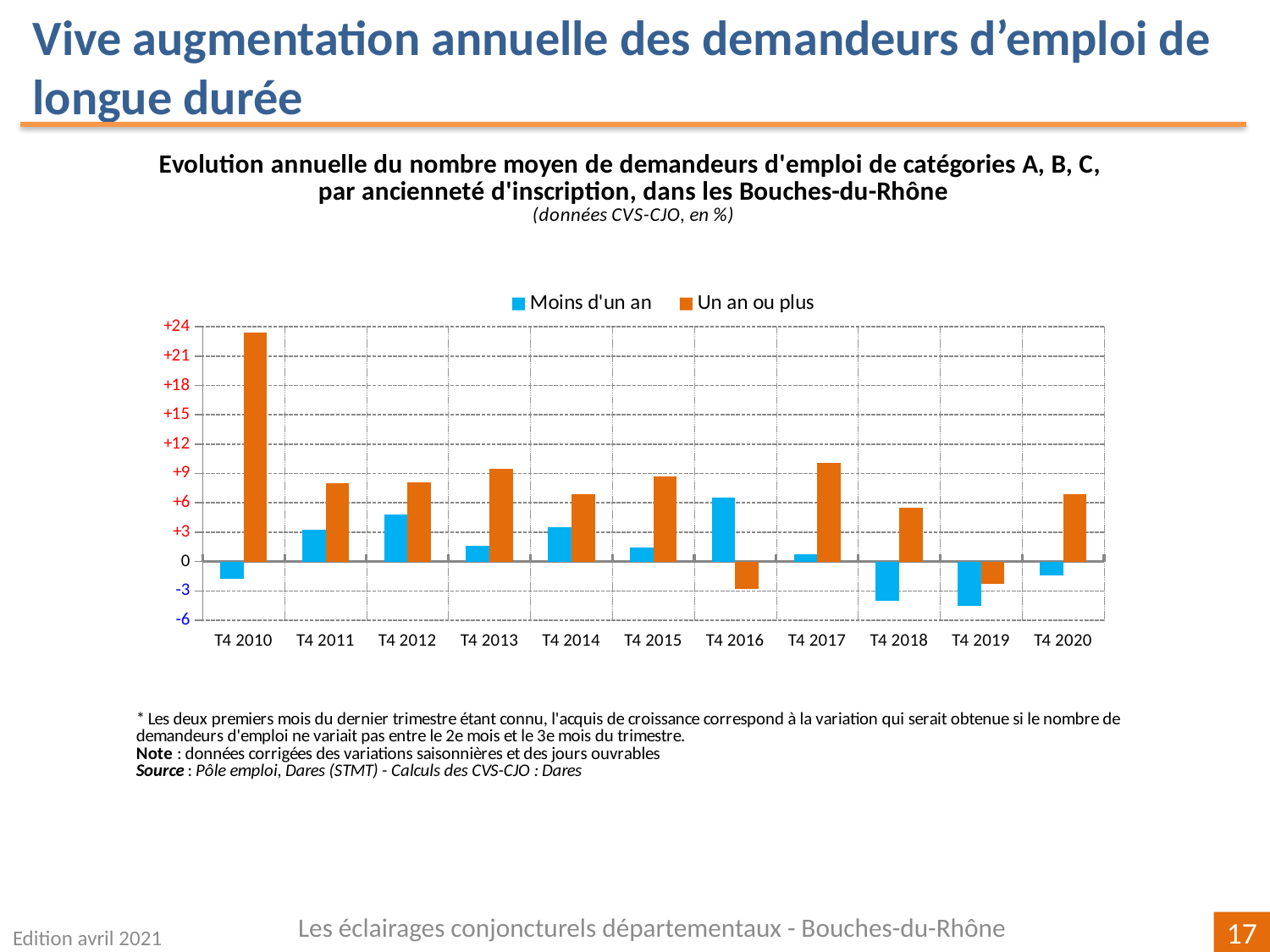
Does the value for 'Un an ou plus' rise or fall from T4 2010 to T4 2011? fall In which quarter is the value for 'Moins d'un an' the highest? T4 2016 Is the value for 'Un an ou plus' in T4 2010 greater or less than +21? greater How many series does the legend list? 2 Is the value for 'Moins d'un an' in T4 2018 greater or less than -3? less Is the value for 'Moins d'un an' in T4 2012 greater or less than +3? greater In T4 2016, which series has the larger value, 'Moins d'un an' or 'Un an ou plus'? Moins d'un an How many quarters (categories) are shown on the x axis? 11 Which colour represents the series 'Moins d'un an' in the legend? Blue In T4 2010, which series has the larger value, 'Moins d'un an' or 'Un an ou plus'? Un an ou plus What kind of chart is shown on the slide? Bar chart In which quarter is the value for 'Un an ou plus' the highest? T4 2010